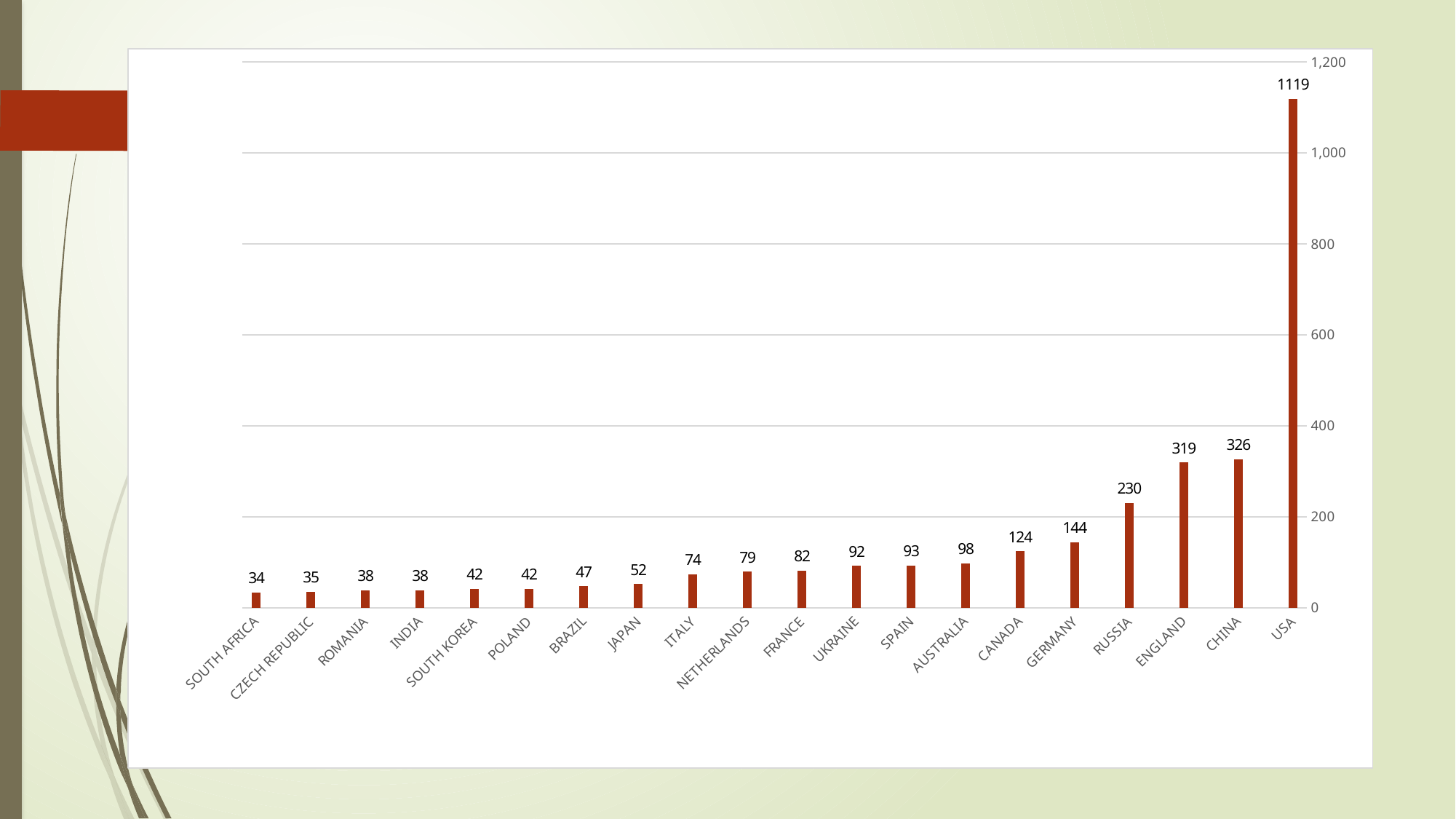
What is the difference between the values for China and England? 7 Do the values rise or fall from left to right along the x axis? Rise What kind of chart is shown on the slide? Bar chart Which country has the highest value? USA Which country has the lowest value? South Africa What is the value for Germany? 144 Which has a larger value, Russia or Canada? Russia Is the value for Russia greater or less than 200? greater What is the value for USA? 1119 What is the value for Japan? 52 What is the difference between the values for USA and China? 793 How many countries are shown on the chart? 20